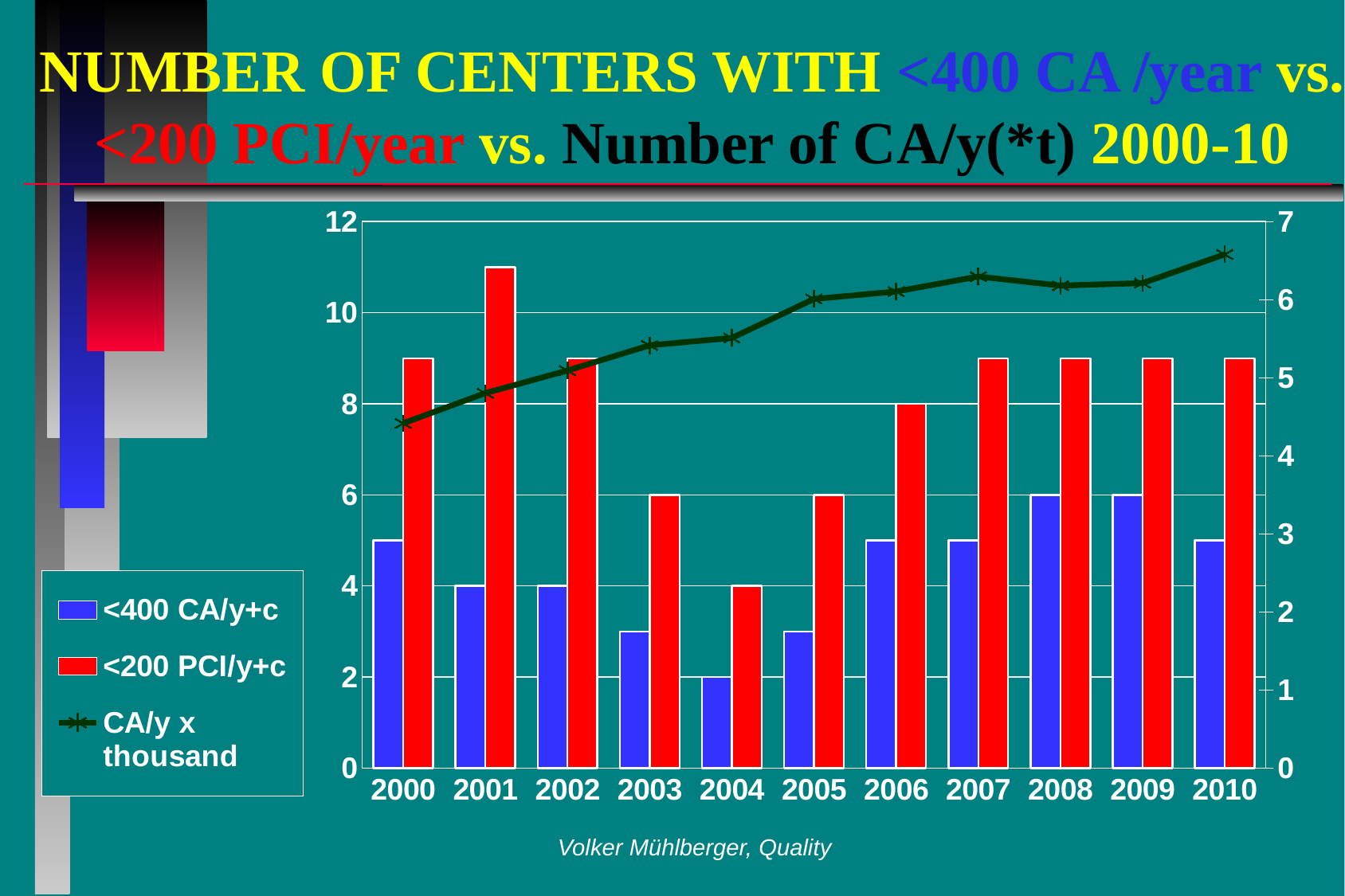
Does the CA/y x thousand line generally rise or fall from 2000 to 2010? rise Is the CA/y x thousand value for 2010 greater or less than 6 on the right axis? greater How many years are shown on the x axis? 11 In which year is the <400 CA/y+c bar lowest? 2004 In which year is the <200 PCI/y+c bar highest? 2001 What is the difference between the <200 PCI/y+c values for 2006 and 2004? 4 What is the value for <200 PCI/y+c in 2004? 4 How many series does the legend list? 3 What is the value for <400 CA/y+c in 2008? 6 What is the value for <200 PCI/y+c in 2006? 8 What is the value for <400 CA/y+c in 2004? 2 Which is larger in 2003: the <400 CA/y+c bar or the <200 PCI/y+c bar? <200 PCI/y+c